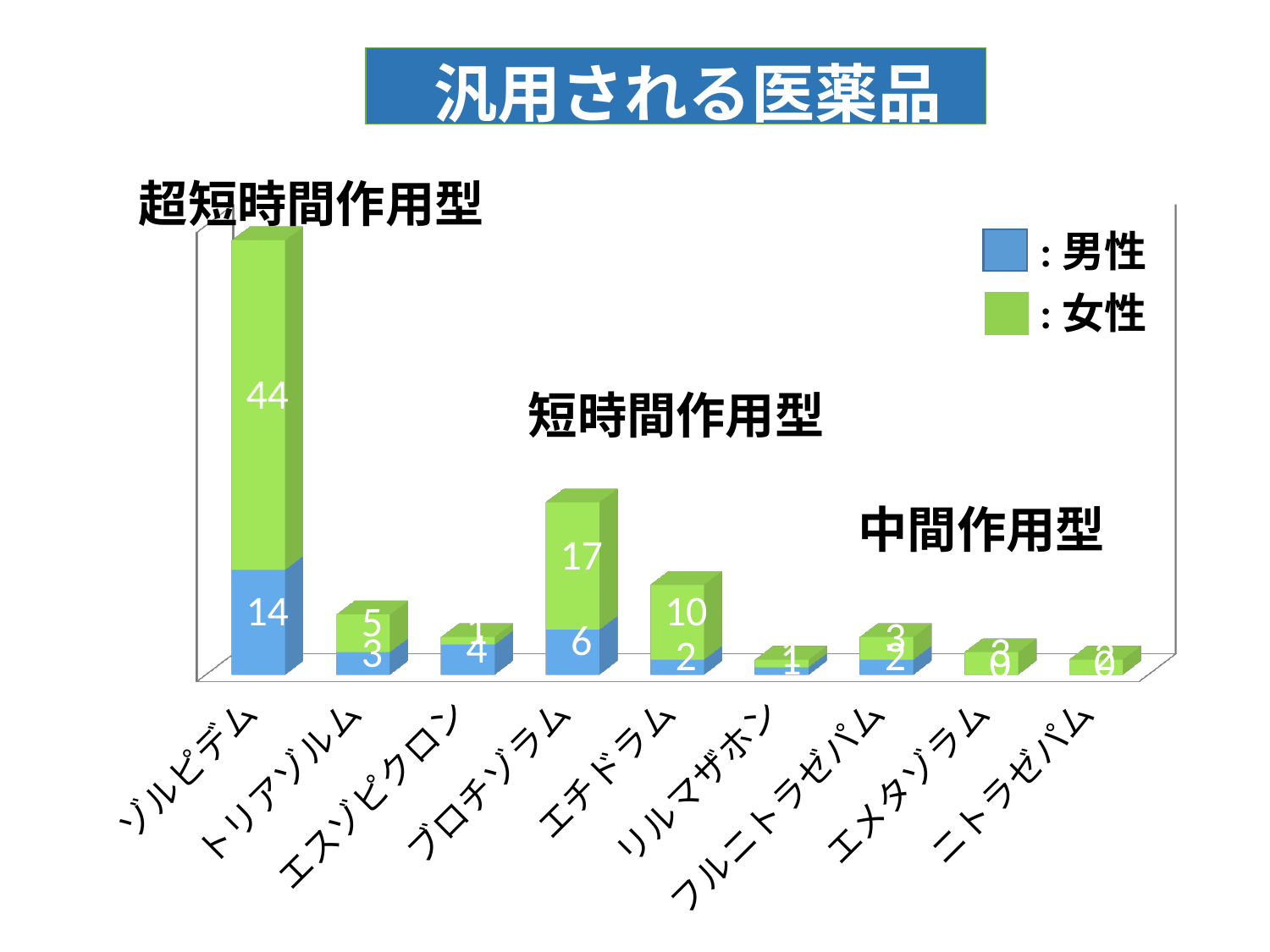
What is the 女性 value for ゾルピデム? 44 What is the total of the stacked bar for ゾルピデム? 58 How many series does the legend list? 2 What is the total of the stacked bar for ブロチゾラム? 23 What kind of chart is shown on the slide? Stacked bar chart What is the 男性 value for ゾルピデム? 14 What is the difference between the 女性 values for ゾルピデム and ブロチゾラム? 27 What is the 女性 value for ブロチゾラム? 17 How many categories are shown on the x axis? 9 Which category has the tallest stacked bar? ゾルピデム